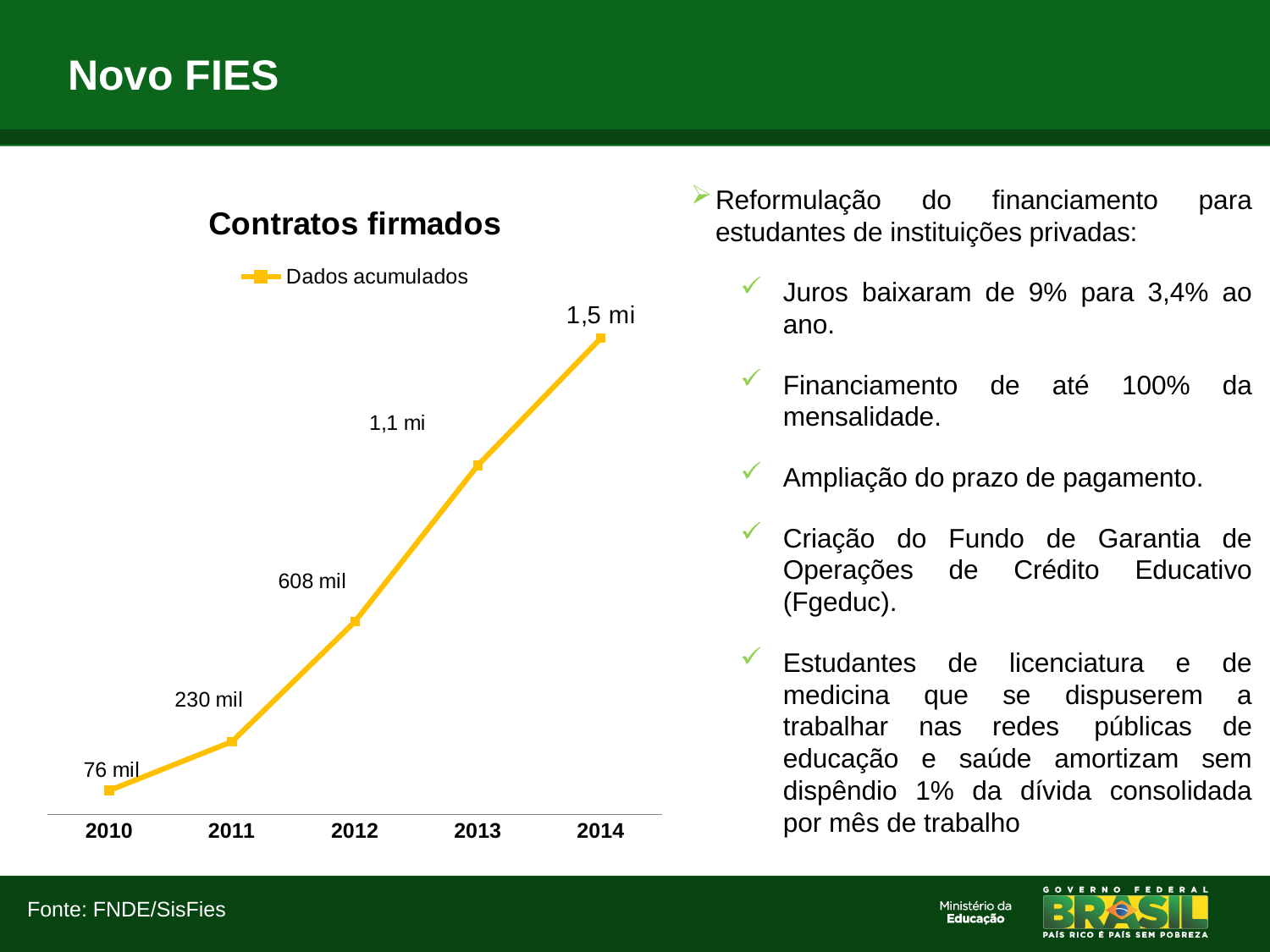
What is the value for 2010 in the 'Contratos firmados' chart? 76 mil Which is larger in the 'Contratos firmados' chart, the value for 2011 or the value for 2012? 2012 What is the difference between the values for 2011 and 2010 in the 'Contratos firmados' chart? 154 mil What is the value for 2013 in the 'Contratos firmados' chart? 1,1 mi Do the values in the 'Contratos firmados' chart rise or fall from 2010 to 2014? Rise What kind of chart is 'Contratos firmados'? Line chart How many years are plotted in the 'Contratos firmados' chart? 5 Which year has the lowest value in the 'Contratos firmados' chart? 2010 What is the difference between the values for 2012 and 2011 in the 'Contratos firmados' chart? 378 mil What is the value for 2012 in the 'Contratos firmados' chart? 608 mil What is the value for 2014 in the 'Contratos firmados' chart? 1,5 mi Which year has the highest value in the 'Contratos firmados' chart? 2014